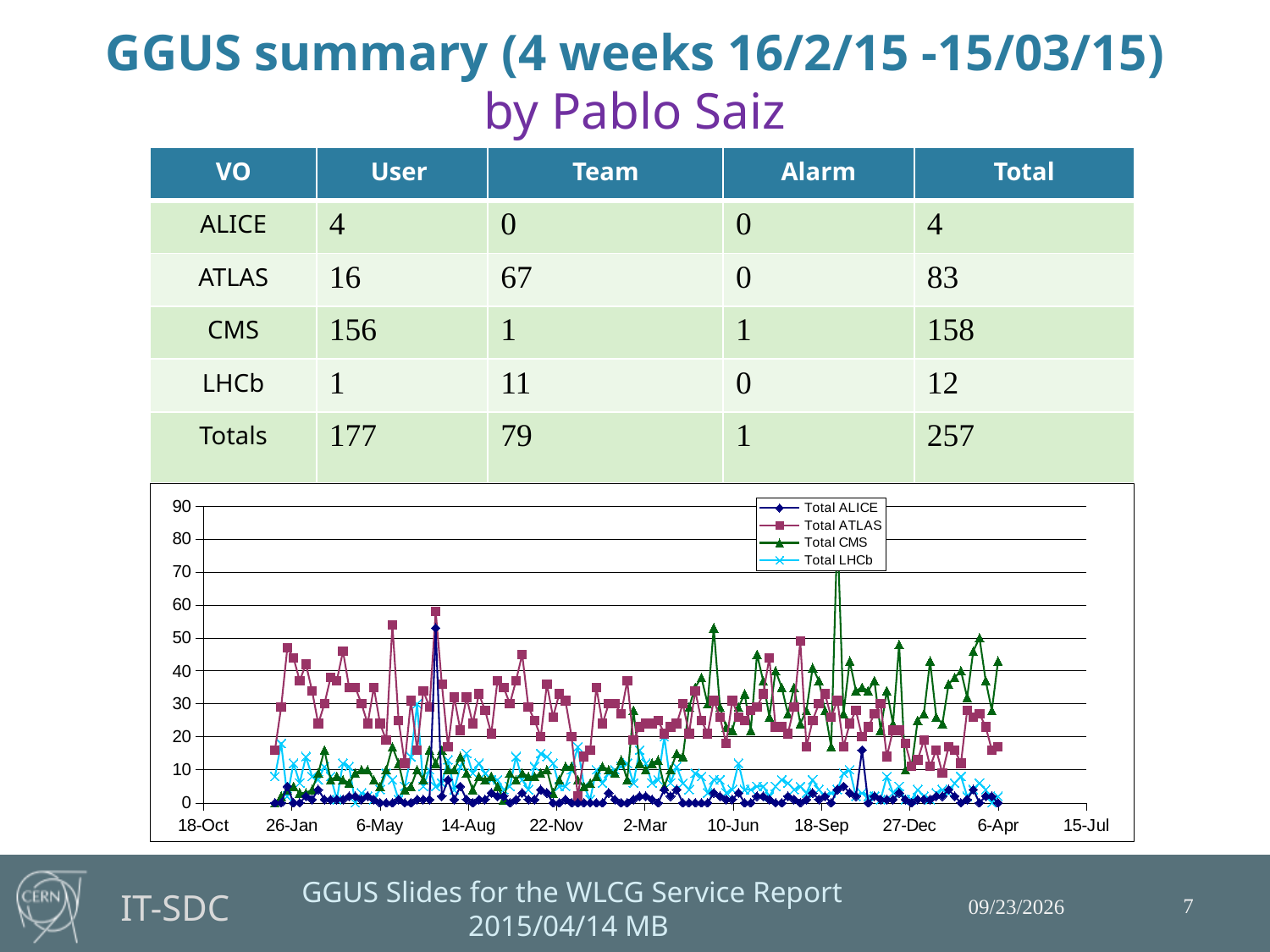
Is the highest peak of the Total ALICE series greater or less than 40? greater Which series are listed in the chart legend? Total ALICE, Total ATLAS, Total CMS, Total LHCb What is the maximum value shown on the chart's vertical axis? 90 Around 14-Aug, which series has the higher peak, Total ATLAS or Total LHCb? Total ATLAS Is the highest peak of the Total CMS series greater or less than 60? greater Which series reaches the highest single value on the chart? Total CMS How many series does the chart legend list? 4 What kind of chart is shown at the bottom of the slide? line chart Which series stays lowest across most of the chart? Total ALICE Is the highest peak of the Total ATLAS series greater or less than 50? greater How many date labels are shown along the chart's x axis? 11